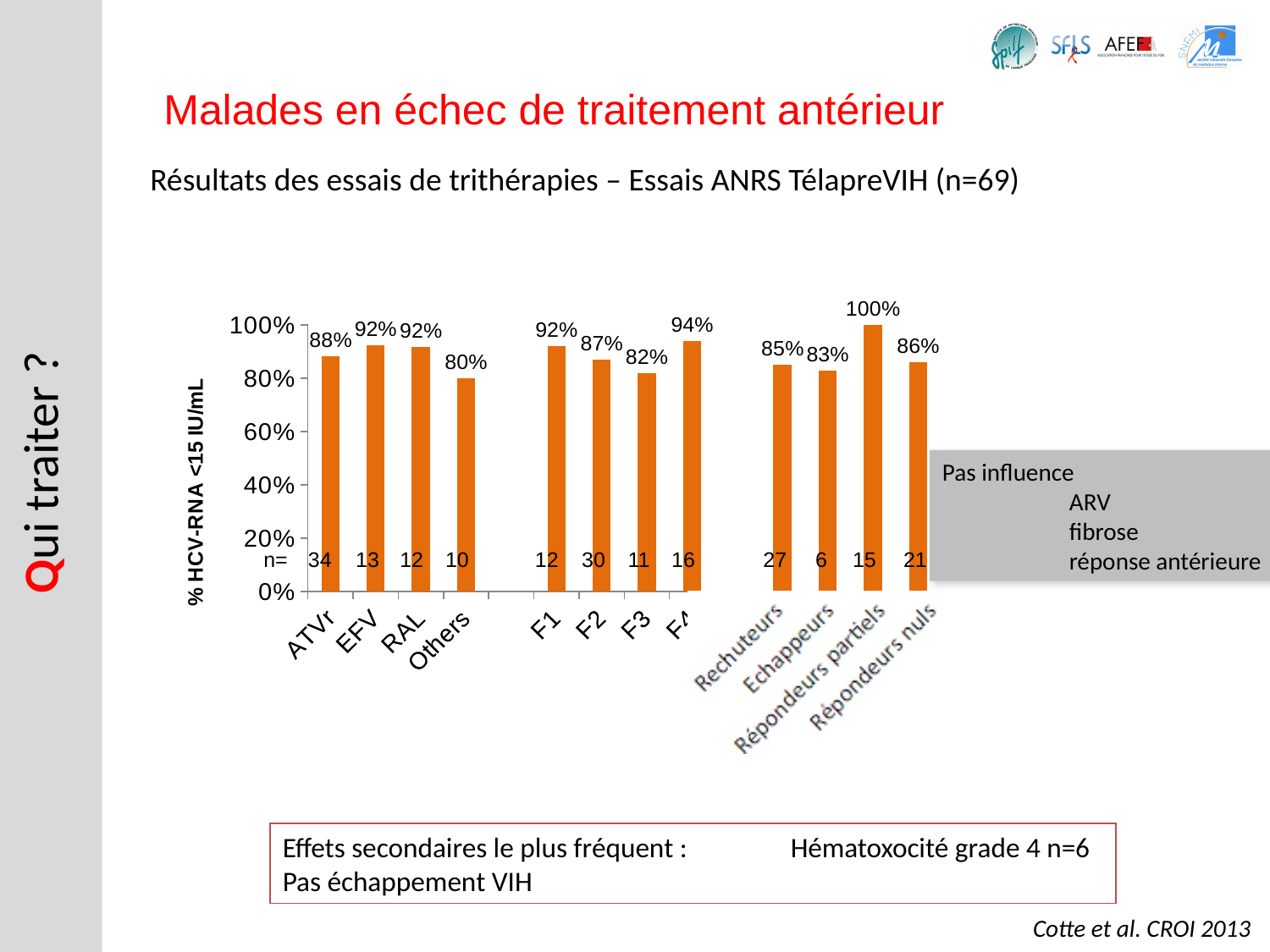
What is the n value shown for Rechuteurs? 27 Which category has the highest value? Répondeurs partiels What is the value for ATVr? 88% What is the difference between the values for EFV and Others? 12 percentage points How many bars are plotted in the chart? 12 What is the value for Répondeurs partiels? 100% What is the label of the vertical axis? % HCV-RNA <15 IU/mL What kind of chart is shown on the slide? Bar chart What is the value for Others? 80% What is the value for Echappeurs? 83% Which is larger, the value for F2 or the value for F3? F2 Which category has the lowest value? Others